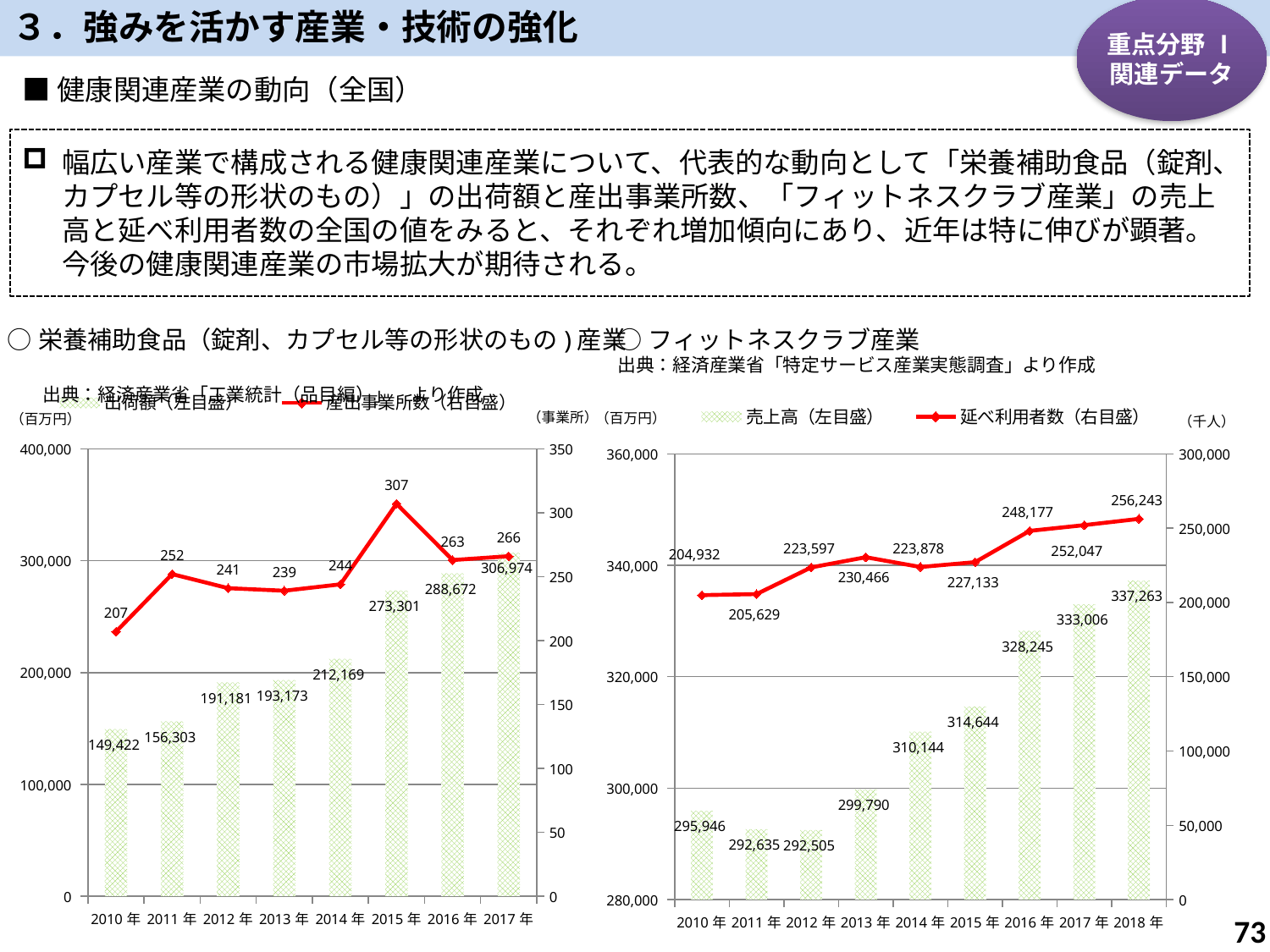
In the 栄養補助食品 chart on the left, how many years are shown on the x axis? 8 In the フィットネスクラブ産業 chart on the right, what is the 売上高 value for 2014年? 310,144 In the 栄養補助食品 chart on the left, which year has the lowest 出荷額? 2010年 In the フィットネスクラブ産業 chart on the right, how many series does the legend list? 2 In the フィットネスクラブ産業 chart on the right, what is the 延べ利用者数 value for 2018年? 256,243 In the フィットネスクラブ産業 chart on the right, which year has the lowest 売上高? 2012年 In the 栄養補助食品 chart on the left, which year has the highest 産出事業所数? 2015年 In the 栄養補助食品 chart on the left, what is the difference in 出荷額 between 2017年 and 2016年? 18,302 In the フィットネスクラブ産業 chart on the right, is the 延べ利用者数 for 2013年 larger or smaller than for 2014年? larger In the 栄養補助食品 chart on the left, what is the 出荷額 value for 2015年? 273,301 In the フィットネスクラブ産業 chart on the right, does the 売上高 generally rise or fall from 2013年 to 2018年? rise In the 栄養補助食品 chart on the left, what is the 産出事業所数 value for 2011年? 252